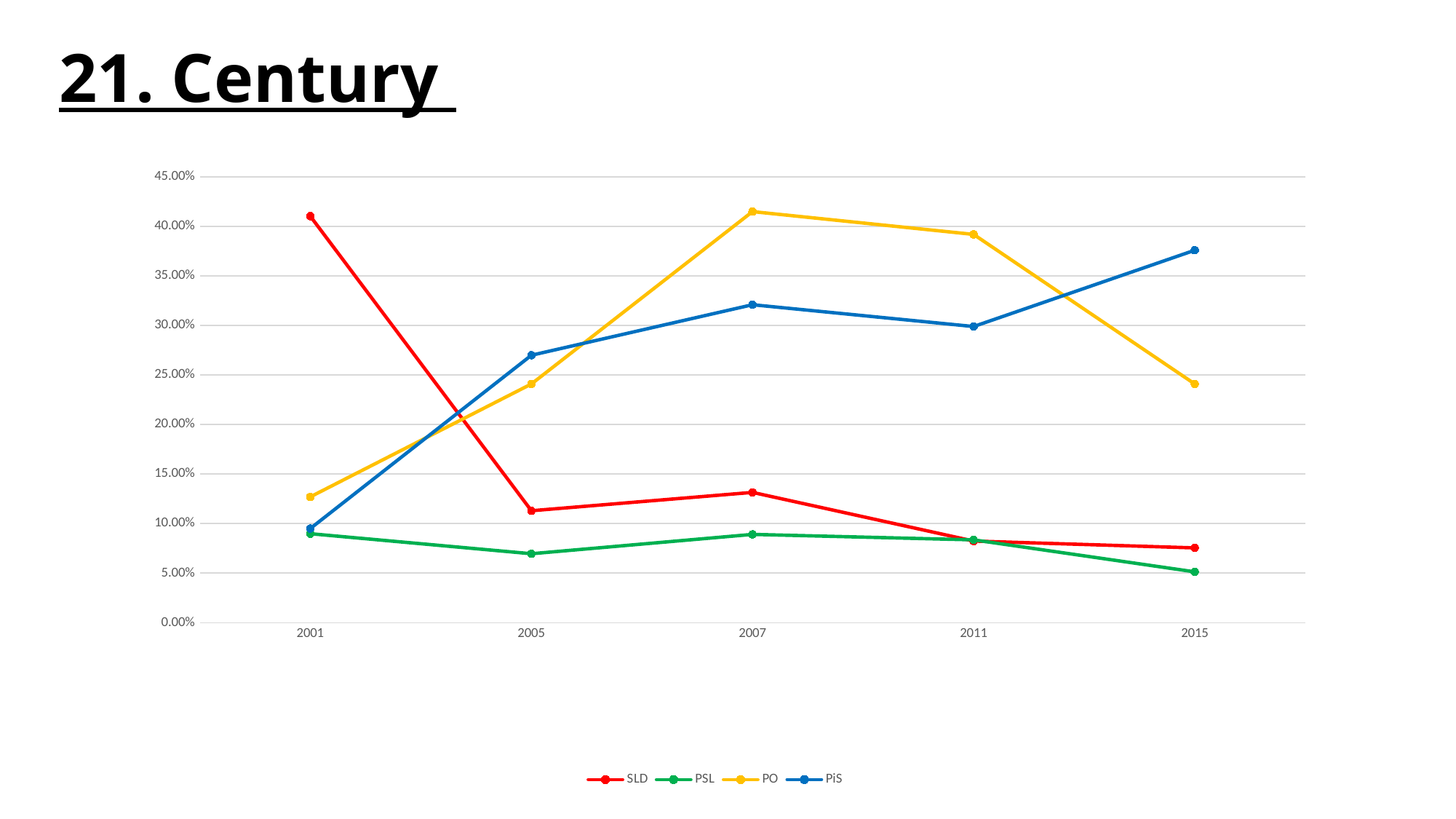
Which series has the highest value in 2015? PiS What kind of chart is shown on the slide? line chart Is the value for PSL in 2015 greater or less than 10.00%? less How many years are shown on the x axis? 5 Which series has the lowest value in 2015? PSL In 2005, which is larger, the value for PiS or the value for PO? PiS How many series does the legend list? 4 What colour is the PO line in the legend? yellow Is the value for SLD in 2001 greater or less than 35.00%? greater Which series has the highest value in 2007? PO Which series has the highest value in 2001? SLD Does the SLD line rise or fall between 2001 and 2005? fall